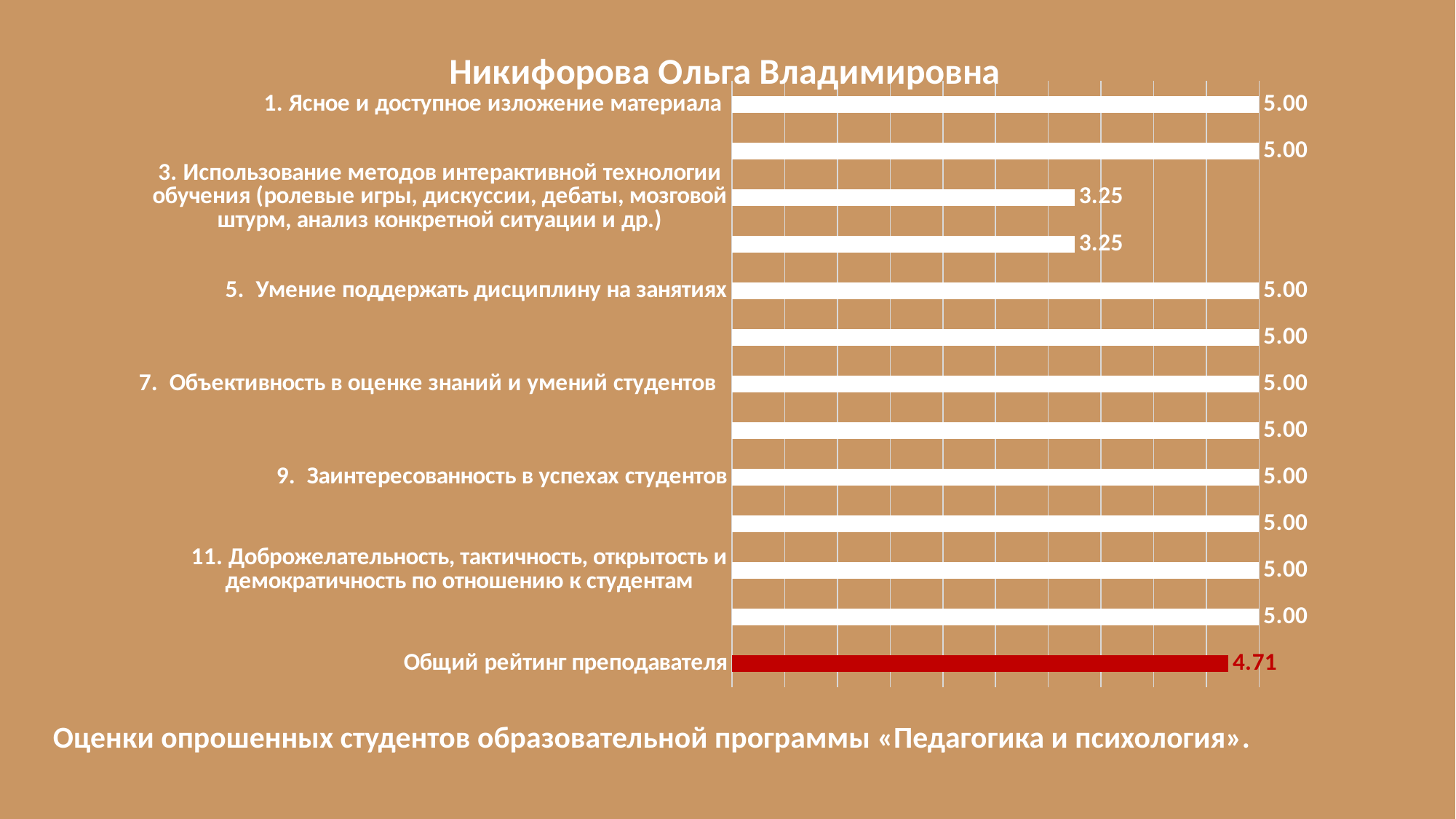
What is the value for "5. Умение поддержать дисциплину на занятиях"? 5.00 Which is larger: the value for "9. Заинтересованность в успехах студентов" or the value for "3. Использование методов интерактивной технологии обучения"? 9. Заинтересованность в успехах студентов What is the value for "1. Ясное и доступное изложение материала"? 5.00 How many bars are plotted on the chart? 13 What is the value for "Общий рейтинг преподавателя"? 4.71 What is the value for "3. Использование методов интерактивной технологии обучения"? 3.25 What is the title of the chart? Никифорова Ольга Владимировна What is the difference between the value for "7. Объективность в оценке знаний и умений студентов" and "Общий рейтинг преподавателя"? 0.29 What is the difference between the value for "1. Ясное и доступное изложение материала" and the value for "3. Использование методов интерактивной технологии обучения"? 1.75 What colour is the bar for "Общий рейтинг преподавателя"? Red What is the lowest value shown on the chart? 3.25 What kind of chart is shown on the slide? Bar chart